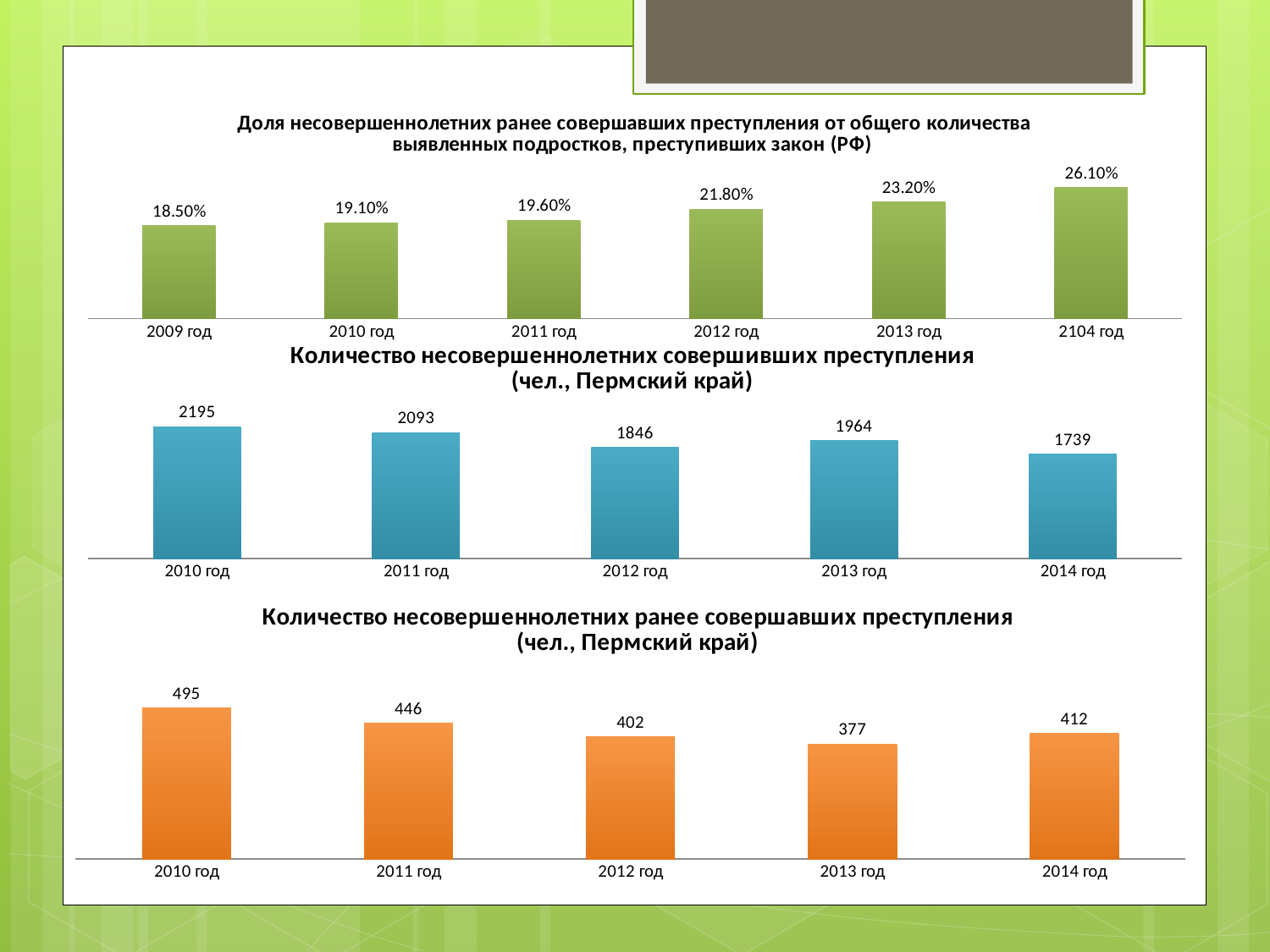
In the top chart, how many bars are plotted? 6 In the top chart, which year has the lowest share? 2009 год In the middle chart, what is the difference between the values for 2010 год and 2014 год? 456 In the bottom chart, which year has the lowest value? 2013 год In the bottom chart (Количество несовершеннолетних ранее совершавших преступления (чел., Пермский край)), what is the value for 2011 год? 446 In the middle chart, which is larger: the value for 2012 год or 2013 год? 2013 год In the top chart (Доля несовершеннолетних ранее совершавших преступления ... (РФ)), what is the value for 2012 год? 21.80% In the middle chart (Количество несовершеннолетних совершивших преступления (чел., Пермский край)), what is the value for 2013 год? 1964 In the top chart, do the values rise or fall from left to right along the x axis? rise In the top chart, which year has the highest share? 2104 год In the middle chart, which year has the lowest value? 2014 год What type of chart is the bottom chart? bar chart